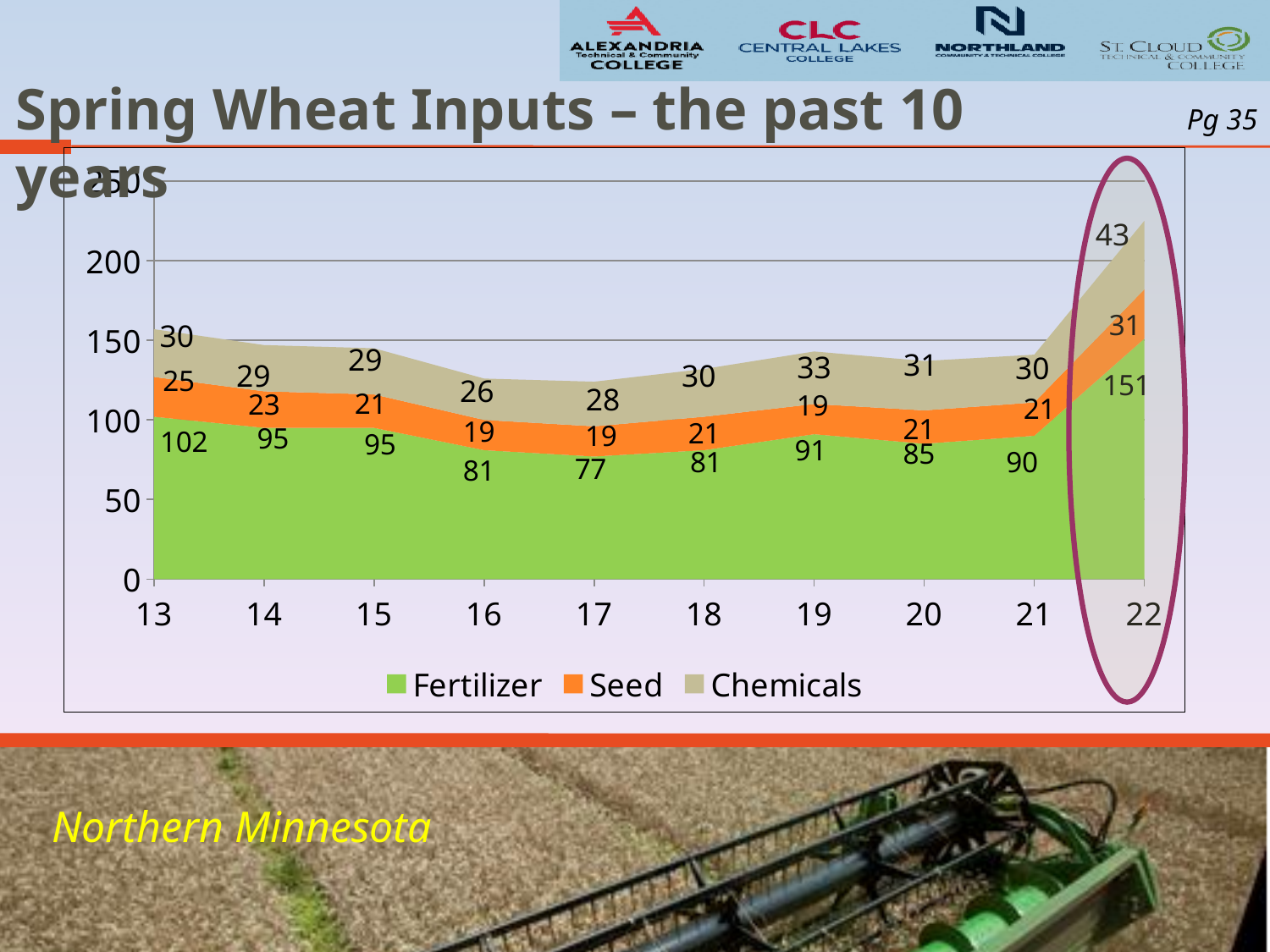
What kind of chart is shown on the slide? Stacked area chart How many series does the legend list? 3 What is the Fertilizer value for year 22? 151 Which series is shown in orange in the legend? Seed How many years are shown on the x axis? 10 What is the Seed value for year 13? 25 Which year has the lowest Fertilizer value? 17 Which year has the highest Fertilizer value? 22 What is the Chemicals value for year 19? 33 What is the difference between the Fertilizer values for year 22 and year 21? 61 What is the total of Fertilizer, Seed and Chemicals for year 22? 225 Which is larger, the Chemicals value for year 19 or for year 16? Year 19